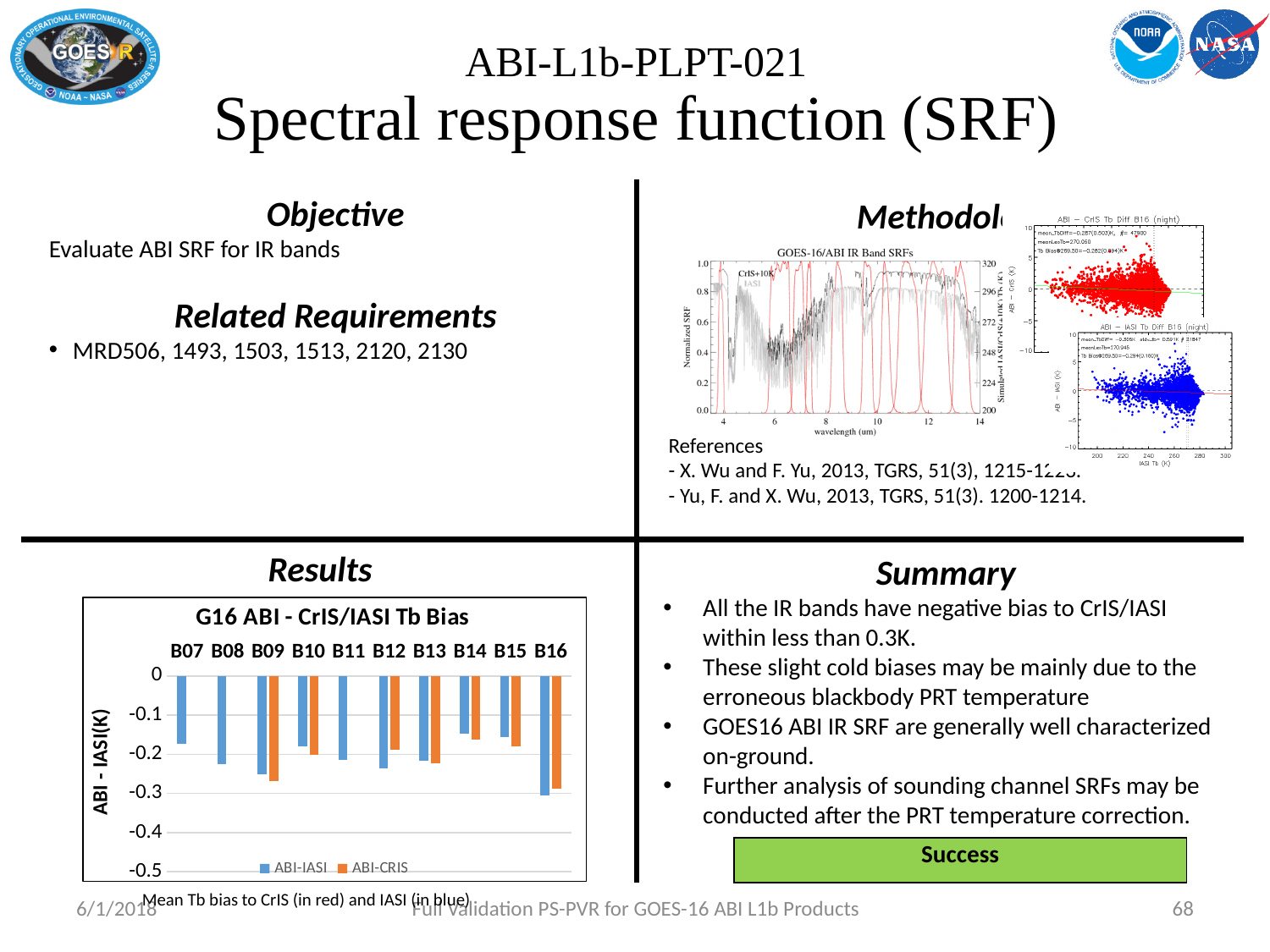
In the G16 ABI - CrIS/IASI Tb Bias chart, which colour represents the ABI-CRIS series? orange How many bands (categories) are shown on the x axis of the G16 ABI - CrIS/IASI Tb Bias chart? 10 What type of chart is shown under Results? bar chart How many series does the legend of the G16 ABI - CrIS/IASI Tb Bias chart list? 2 In the G16 ABI - CrIS/IASI Tb Bias chart, is the ABI-IASI value for B14 greater or less than -0.2? greater In the G16 ABI - CrIS/IASI Tb Bias chart, which band has the most negative ABI-IASI bias? B16 In the G16 ABI - CrIS/IASI Tb Bias chart, is the ABI-IASI value for B16 greater or less than -0.2? less In the G16 ABI - CrIS/IASI Tb Bias chart, is the ABI-IASI value for B08 greater or less than -0.2? less In the G16 ABI - CrIS/IASI Tb Bias chart, which band has the higher (less negative) ABI-IASI value, B07 or B08? B07 What is the title of the bar chart in the Results section? G16 ABI - CrIS/IASI Tb Bias